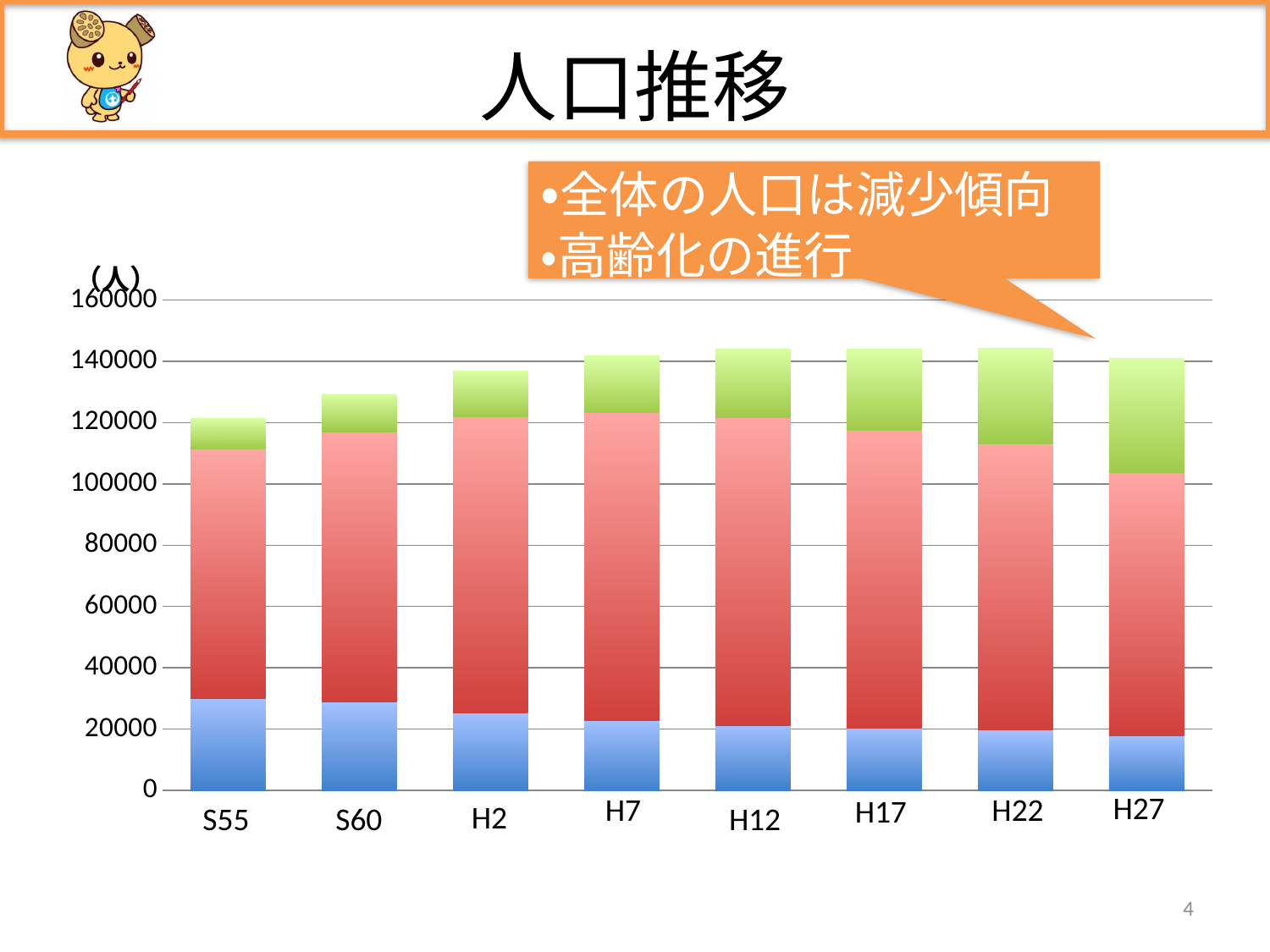
Which has the larger total bar height, S55 or H27? H27 What kind of chart is shown on the slide? Stacked bar chart What is the title of the slide containing the chart? 人口推移 How many categories (years) are shown on the x axis? 8 Which category has the lowest total bar height? S55 Is the total bar height for H12 greater or less than 140000? greater Does the green (top) segment rise or fall from S55 to H27? rise Is the blue (bottom) segment for S55 greater or less than 20000? greater Is the total bar height for S55 greater or less than 140000? less Does the blue (bottom) segment rise or fall from S55 to H27? fall Which has the larger blue (bottom) segment, S55 or H27? S55